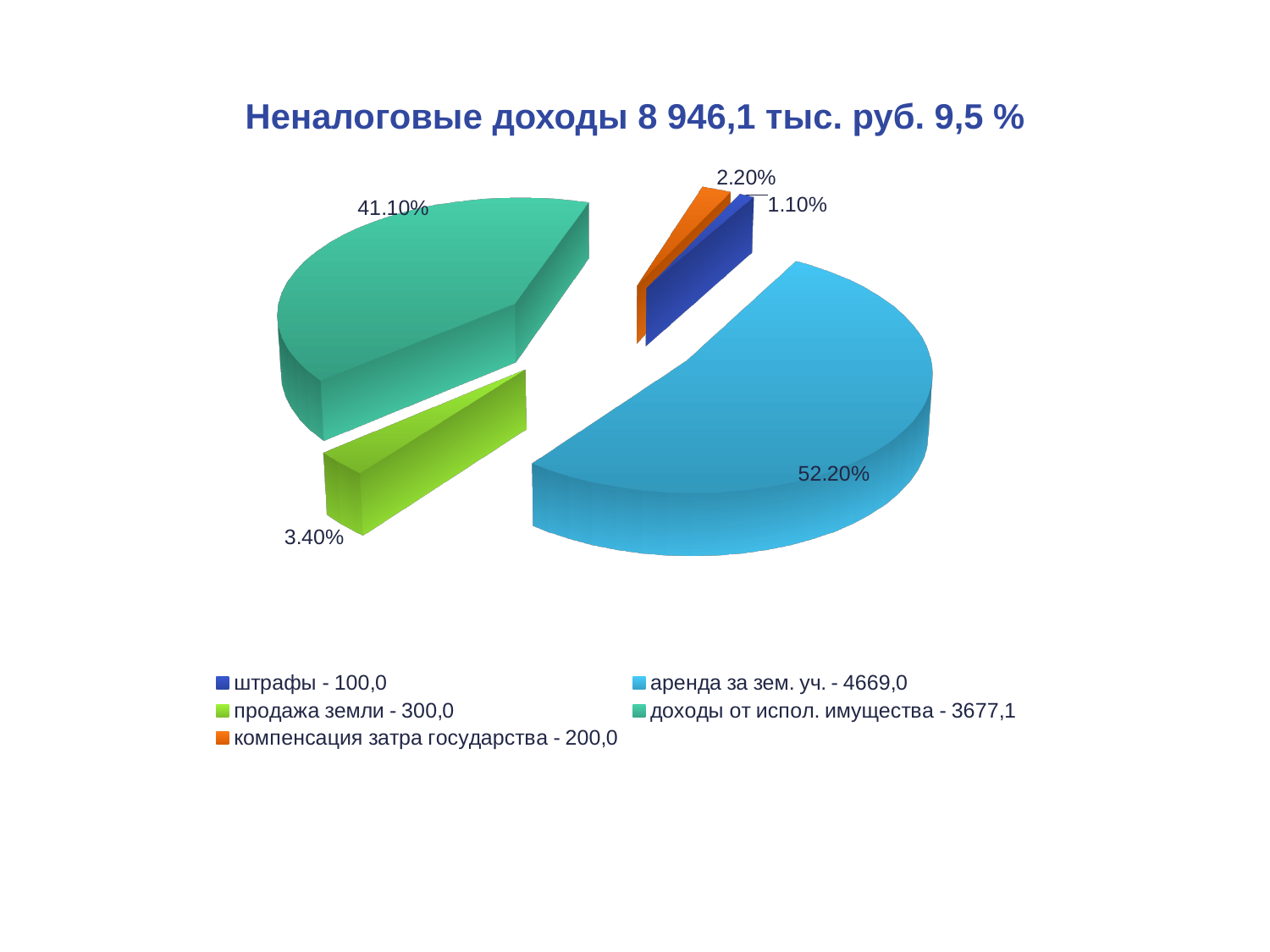
What share of the pie does the slice for "продажа земли - 300,0" represent? 3.40% What share of the pie does the slice for "компенсация затра государства - 200,0" represent? 2.20% What share of the pie does the slice for "аренда за зем. уч. - 4669,0" represent? 52.20% Which slice is larger: "продажа земли - 300,0" or "компенсация затра государства - 200,0"? продажа земли - 300,0 How many slices does the pie chart have? 5 Which category has the largest slice of the pie? аренда за зем. уч. - 4669,0 What is the title of the chart? Неналоговые доходы 8 946,1 тыс. руб. 9,5 % Which category has the smallest slice of the pie? штрафы - 100,0 What is the difference in percentage points between the "аренда за зем. уч." slice and the "доходы от испол. имущества" slice? 11.10% What kind of chart is shown on the slide? pie chart